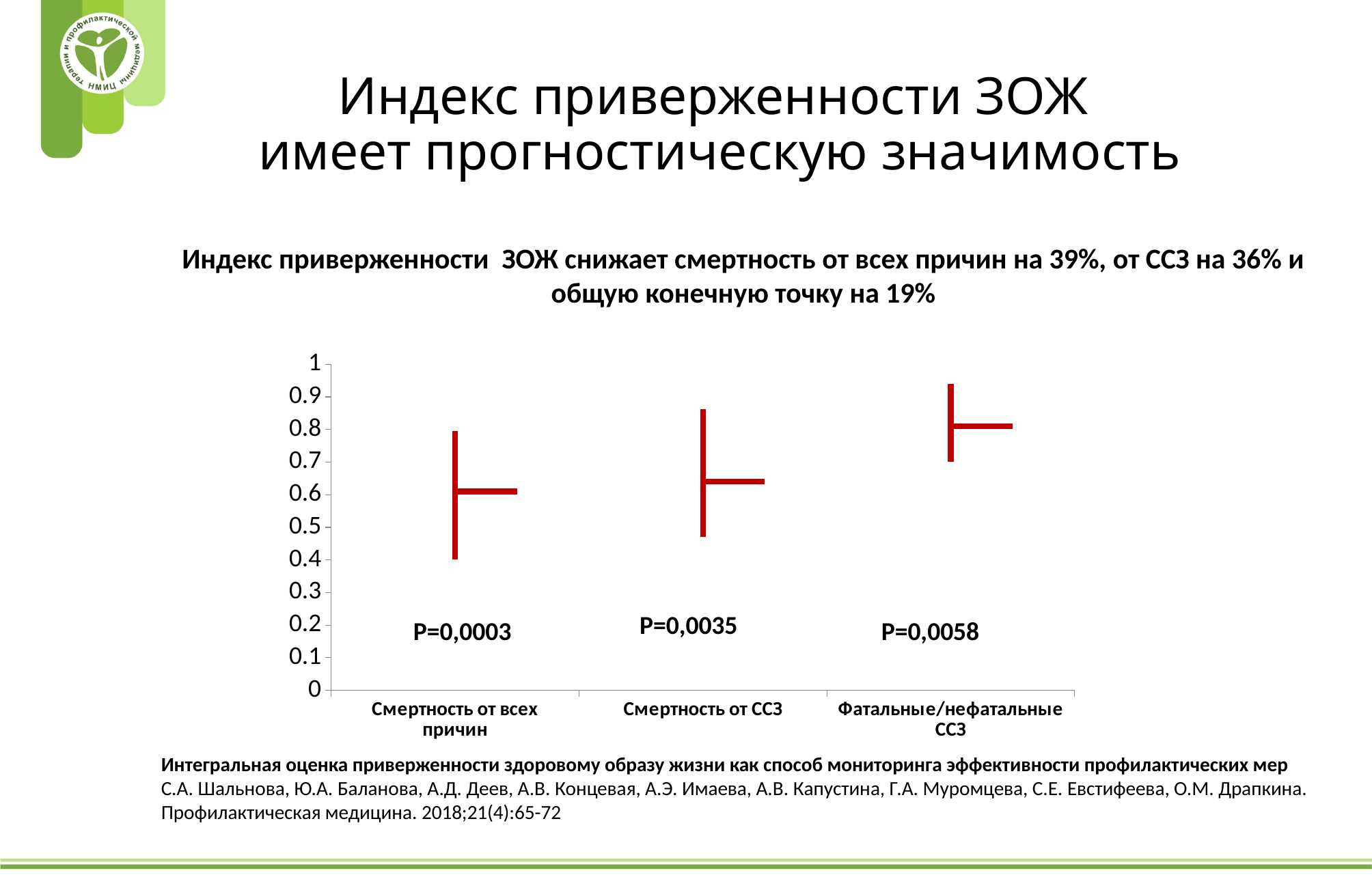
What P-value is printed for the category "Смертность от ССЗ"? P=0,0035 What P-value is printed for the category "Фатальные/нефатальные ССЗ"? P=0,0058 What is the maximum value shown on the y axis of the chart? 1 Which has the larger plotted point value: "Смертность от всех причин" or "Фатальные/нефатальные ССЗ"? Фатальные/нефатальные ССЗ What colour are the plotted markers and error bars in the chart? Red How many categories are shown on the x axis of the chart? 3 Is the plotted point value for "Фатальные/нефатальные ССЗ" greater or less than 0.7? greater Is the plotted point value for "Смертность от всех причин" greater or less than 0.7? less What P-value is printed for the category "Смертность от всех причин"? P=0,0003 Is the plotted point value for "Смертность от ССЗ" greater or less than 0.8? less Which category has the smallest P-value printed on the chart? Смертность от всех причин Which category has the highest plotted point value? Фатальные/нефатальные ССЗ